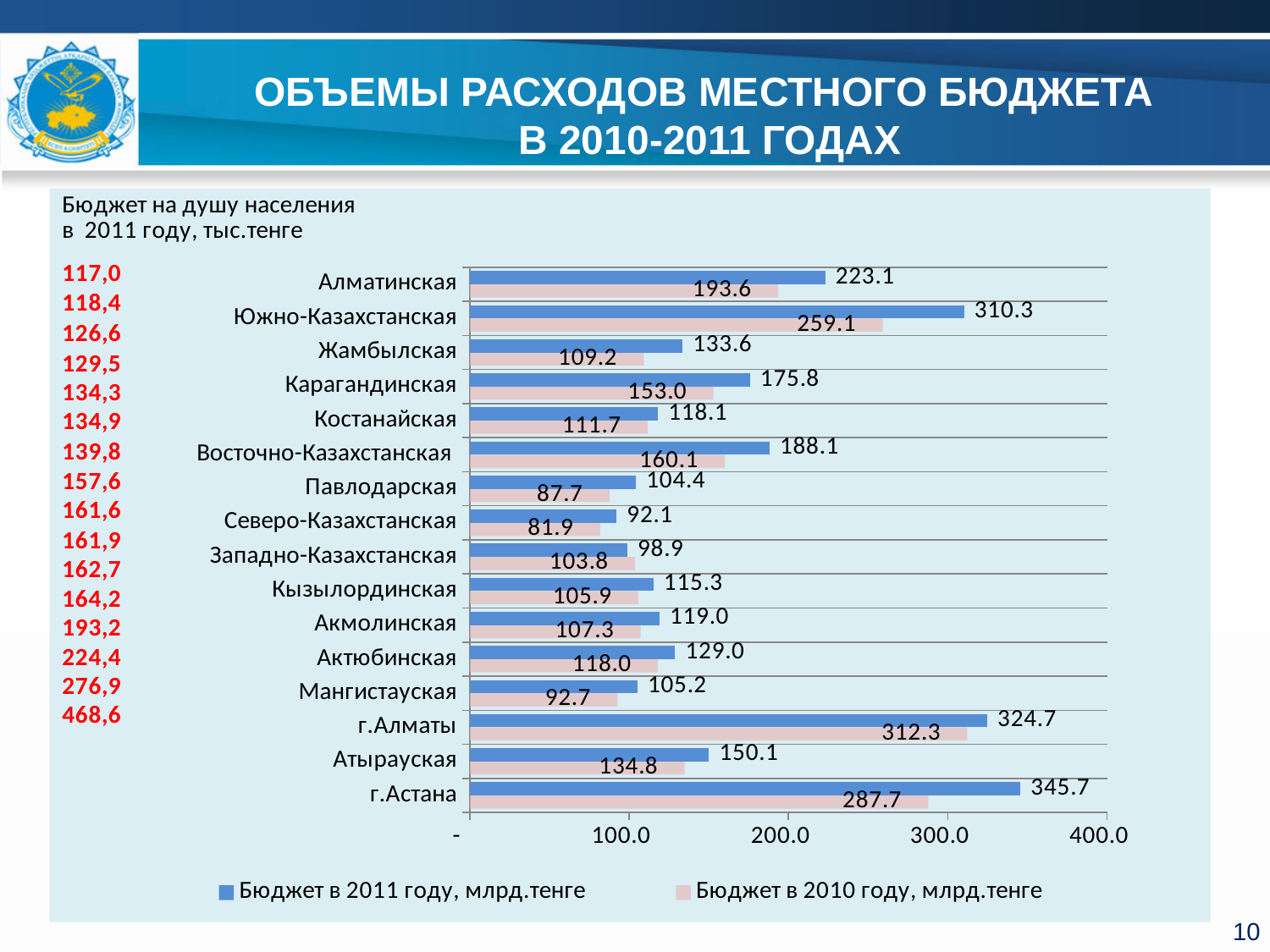
Which category has the highest value in the series 'Бюджет в 2010 году, млрд.тенге'? г.Алматы Is the 2011 value for г.Алматы greater or less than 300.0? greater What is the difference between the 2011 and 2010 values for Алматинская? 29.5 Which category has the lowest value in the series 'Бюджет в 2010 году, млрд.тенге'? Северо-Казахстанская How many categories (regions) are shown on the chart? 16 What colour are the bars for the series 'Бюджет в 2011 году, млрд.тенге'? Blue How many series does the legend list? 2 For Западно-Казахстанская, which series has the larger value: 'Бюджет в 2011 году' or 'Бюджет в 2010 году'? Бюджет в 2010 году, млрд.тенге Which category has the highest value in the series 'Бюджет в 2011 году, млрд.тенге'? г.Астана What is the value for Павлодарская in the series 'Бюджет в 2010 году, млрд.тенге'? 87.7 What is the value for Южно-Казахстанская in the series 'Бюджет в 2011 году, млрд.тенге'? 310.3 What kind of chart is shown on the slide? Bar chart